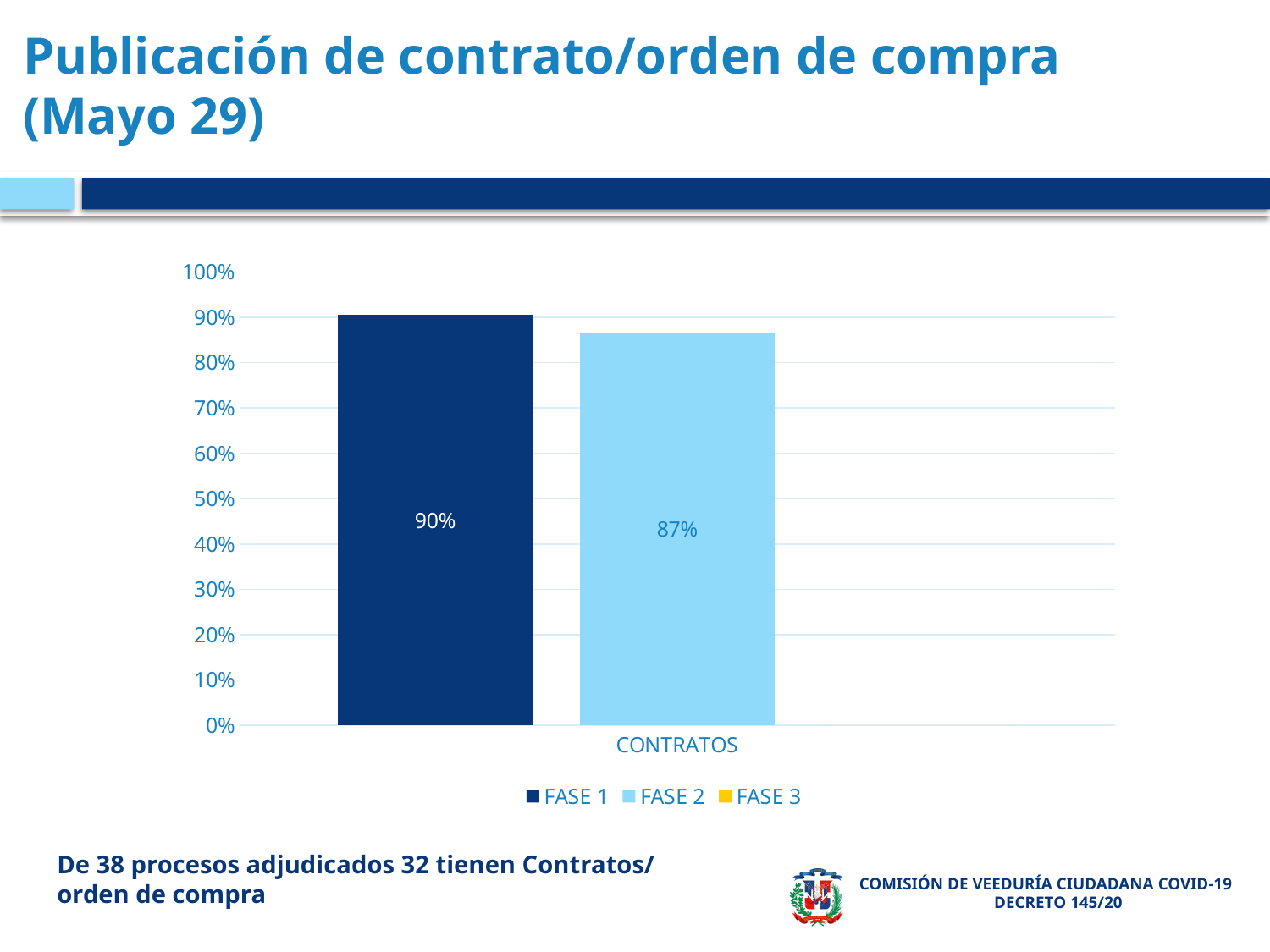
How many categories are shown on the x axis? 1 Is the value for FASE 1 greater or less than 100%? less What is the value for FASE 2 in the CONTRATOS category? 87% Which series has the highest value for CONTRATOS? FASE 1 Which legend series has no visible bar in the chart? FASE 3 What kind of chart is shown on the slide? bar chart Which is larger for CONTRATOS, FASE 1 or FASE 2? FASE 1 What is the difference between the FASE 1 and FASE 2 values for CONTRATOS? 3% What is the category label on the x axis? CONTRATOS How many series does the legend list? 3 What is the value for FASE 1 in the CONTRATOS category? 90% Is the value for FASE 2 greater or less than 80%? greater